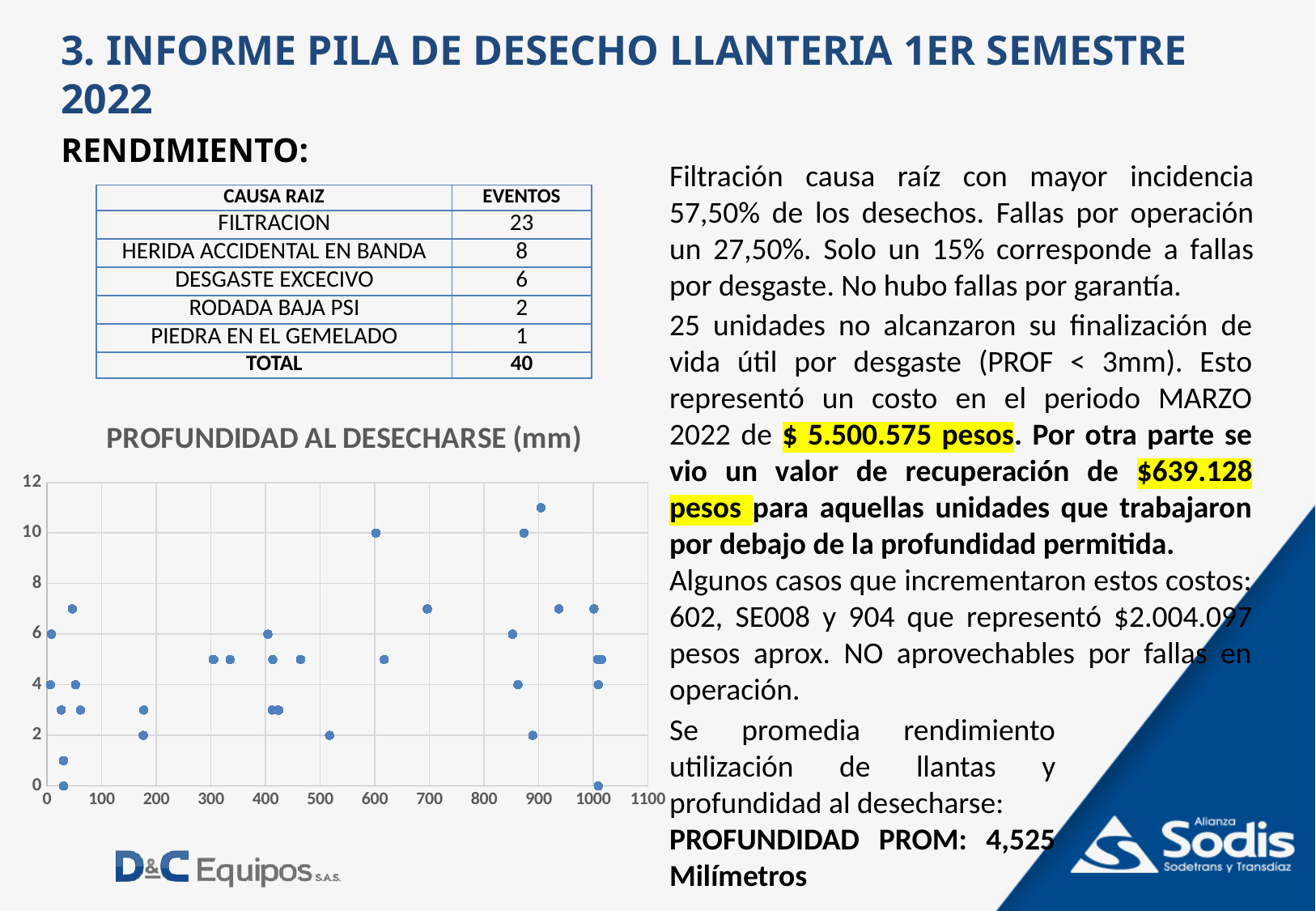
Is the plotted point near x = 500 greater or less than 4? less What is the highest value shown on the y axis of the chart? 12 Are the plotted points near x = 300 greater or less than 4? greater Is the highest plotted point in the chart greater or less than 12? less What is the title of the chart on the slide? PROFUNDIDAD AL DESECHARSE (mm) What is the highest value shown on the x axis of the chart? 1100 What kind of chart is shown on the slide? scatter chart What is the interval between consecutive tick labels on the y axis? 2